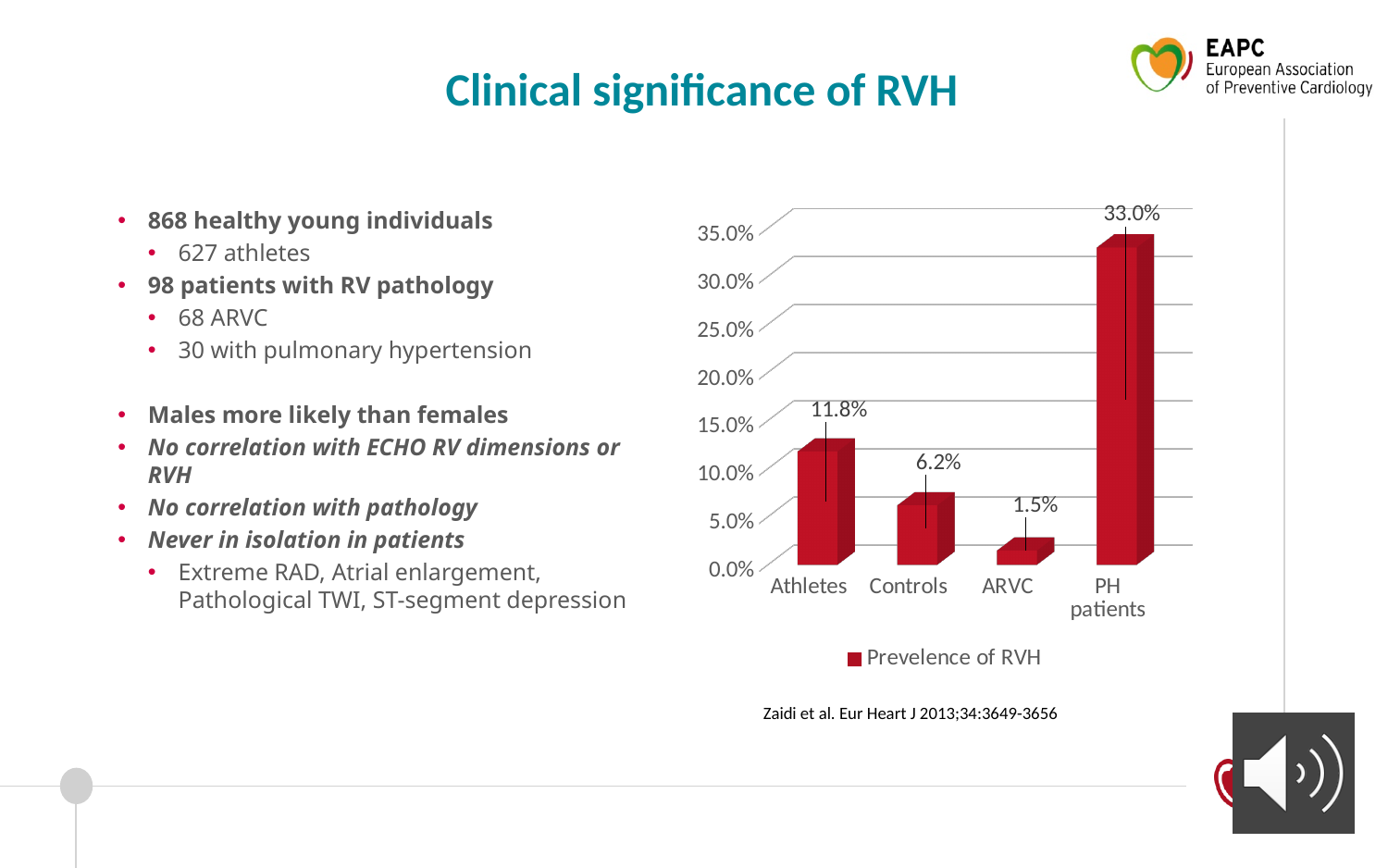
Which has a higher prevalence of RVH, Athletes or Controls? Athletes What is the prevalence of RVH for PH patients? 33.0% Which category has the highest prevalence of RVH? PH patients What is the prevalence of RVH for Controls? 6.2% What is the prevalence of RVH for Athletes? 11.8% How many categories are shown on the x axis of the chart? 4 Which category has the lowest prevalence of RVH? ARVC What type of chart is shown on the slide? Bar chart What is the prevalence of RVH for ARVC? 1.5% What is the difference in prevalence of RVH between Athletes and Controls? 5.6% What is the difference in prevalence of RVH between PH patients and Athletes? 21.2% What is the legend entry of the chart? Prevelence of RVH